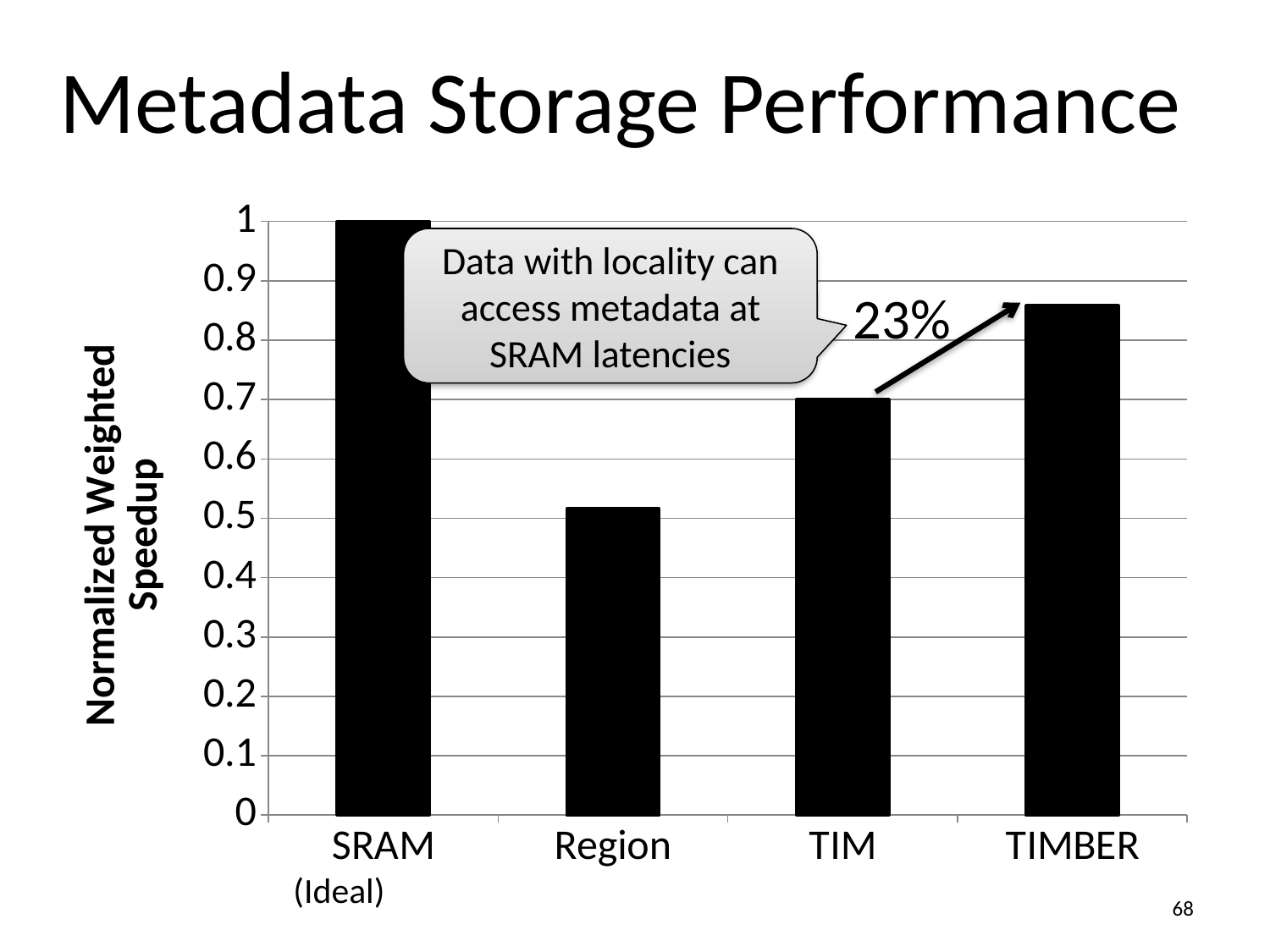
Which has a larger normalized weighted speedup, Region or TIM? TIM Is the value for Region greater or less than 0.6? less Which category has the highest normalized weighted speedup? SRAM (Ideal) What percentage improvement is annotated between the TIM and TIMBER bars? 23% Which category has the lowest normalized weighted speedup? Region Is the value for TIM greater or less than 0.6? greater What is the normalized weighted speedup for SRAM (Ideal)? 1 What is the label of the y axis? Normalized Weighted Speedup Which has a larger normalized weighted speedup, TIM or TIMBER? TIMBER Is the value for TIMBER greater or less than 0.8? greater What kind of chart is shown on the slide? bar chart How many categories are plotted on the x axis? 4